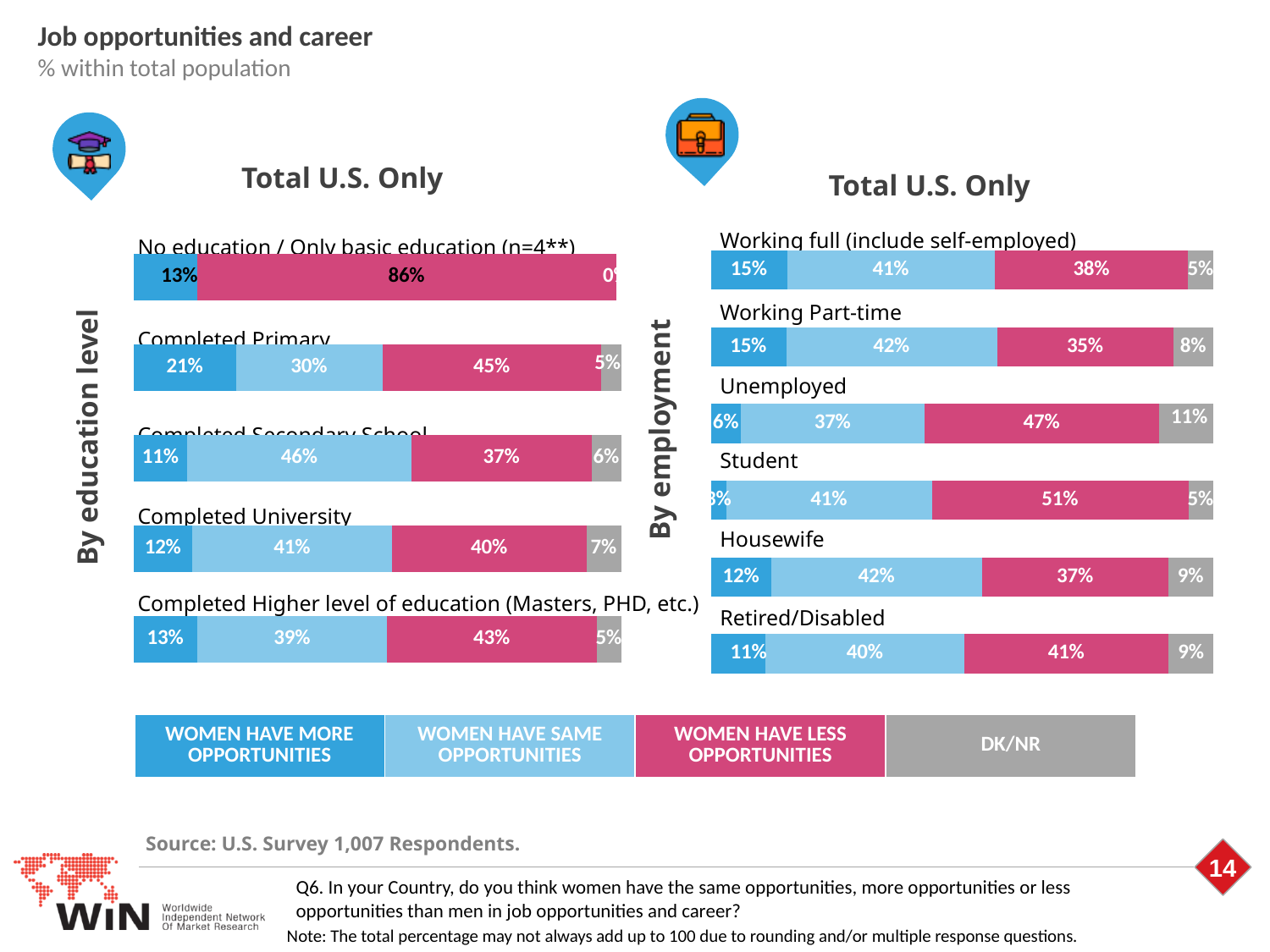
In the 'By education level' chart, what percentage of Completed Primary respondents say women have more opportunities? 21% In the 'By employment' chart, what is the DK/NR value for Housewife? 9% In the 'By employment' chart, which category has the highest share saying women have less opportunities? Student How many series does the legend list? 4 In the 'By education level' chart, what is the total of the Completed Secondary School bar? 100% In the 'By education level' chart, which category has the highest share saying women have the same opportunities? Completed Secondary School In the 'By employment' chart, what percentage of Unemployed respondents say women have less opportunities? 47% How many employment categories are shown in the 'By employment' chart? 6 What kind of chart is used on this slide? Stacked bar chart In the 'By education level' chart, for Completed Higher level of education, which is larger: 'women have same opportunities' or 'women have less opportunities'? Women have less opportunities In the 'By education level' chart, which category has the lowest share saying women have the same opportunities? No education / Only basic education In the 'By employment' chart, for Working Part-time, what is the difference between the 'women have same opportunities' and 'women have less opportunities' values? 7 percentage points